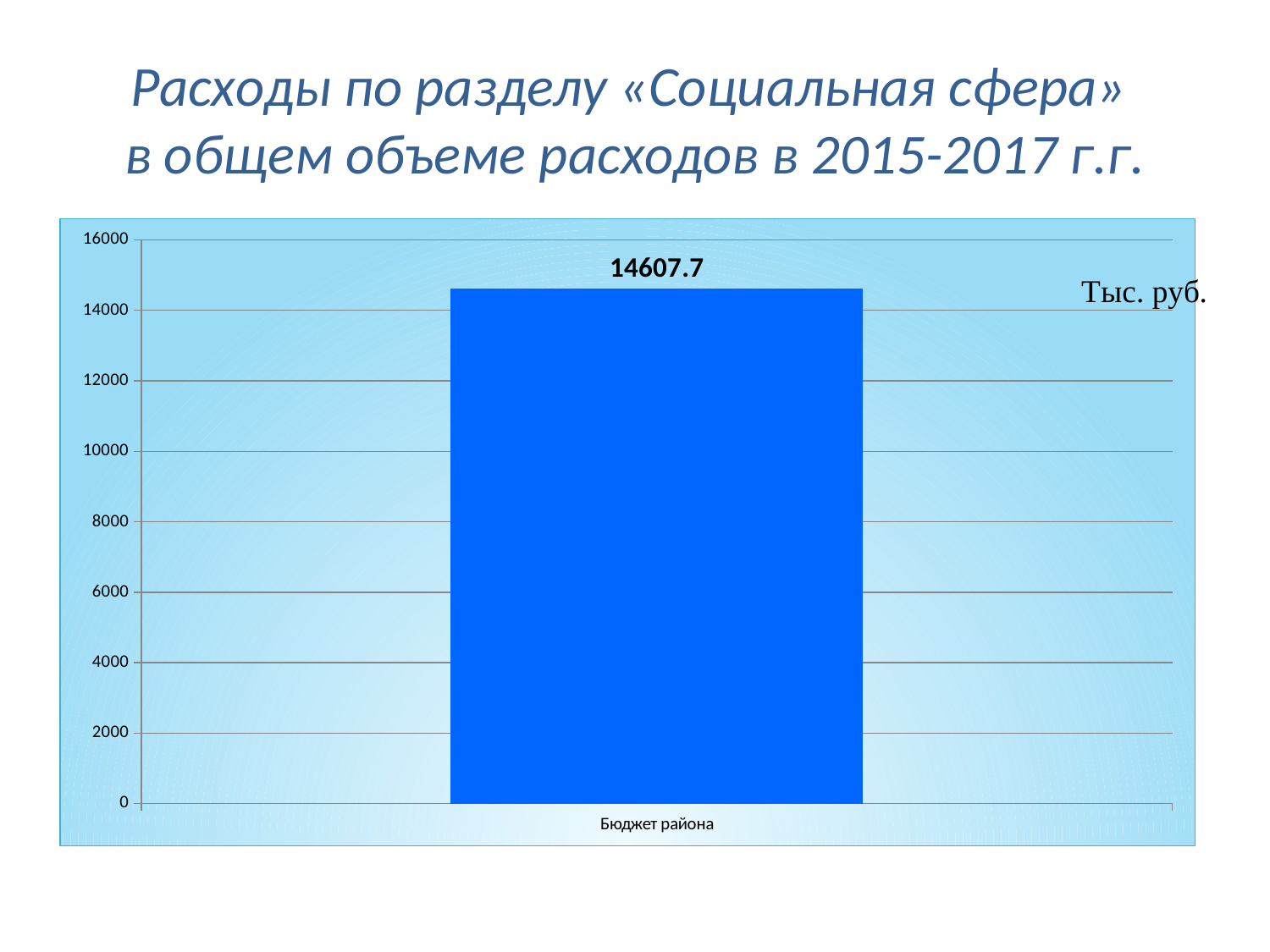
What unit is indicated next to the chart? Тыс. руб. What is the value shown for "Бюджет района"? 14607.7 How many categories are plotted on the x axis? 1 Is the value for "Бюджет района" greater or less than 14000? greater What kind of chart is shown on the slide? bar chart What is the label of the single category on the x axis? Бюджет района What is the highest value shown on the vertical axis? 16000 Is the value for "Бюджет района" greater or less than 16000? less